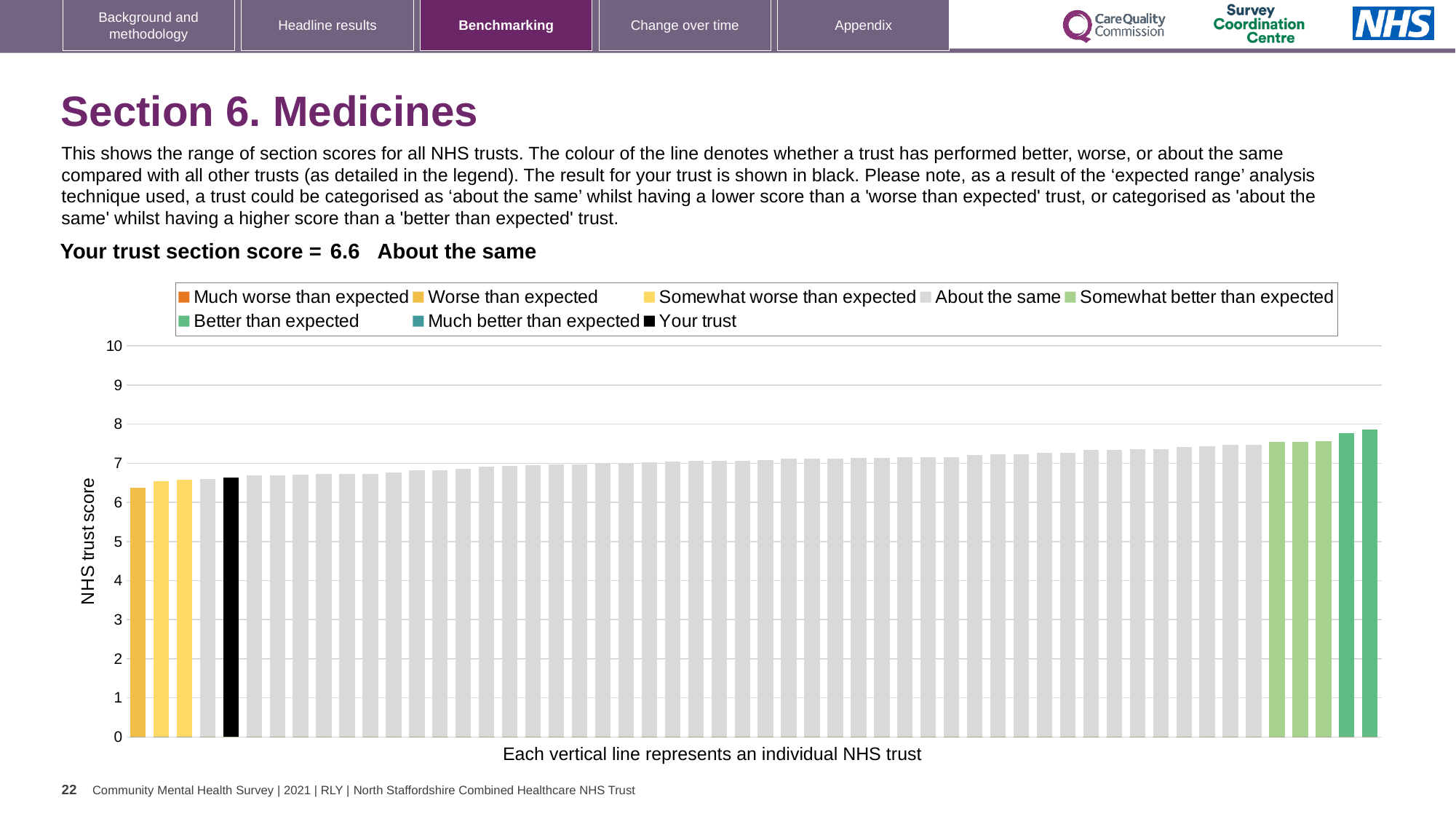
How many entries does the chart legend list? 8 Is the value of the tallest bar on the chart greater or less than 7? greater What is the label on the y axis of the chart? NHS trust score How many bars on the chart are black? 1 How many bars are coloured in the 'Better than expected' dark green shade? 2 Do the bar values rise or fall moving from left to right along the x axis? Rise Is the value of the shortest bar on the chart greater or less than 7? less Is the value of the black 'Your trust' bar greater or less than 5? greater What is the section score for your trust shown on the slide? 6.6 What does the x-axis caption say each vertical line represents? An individual NHS trust Which category is your trust placed in for the Medicines section score? About the same What kind of chart is shown on the slide? Bar chart